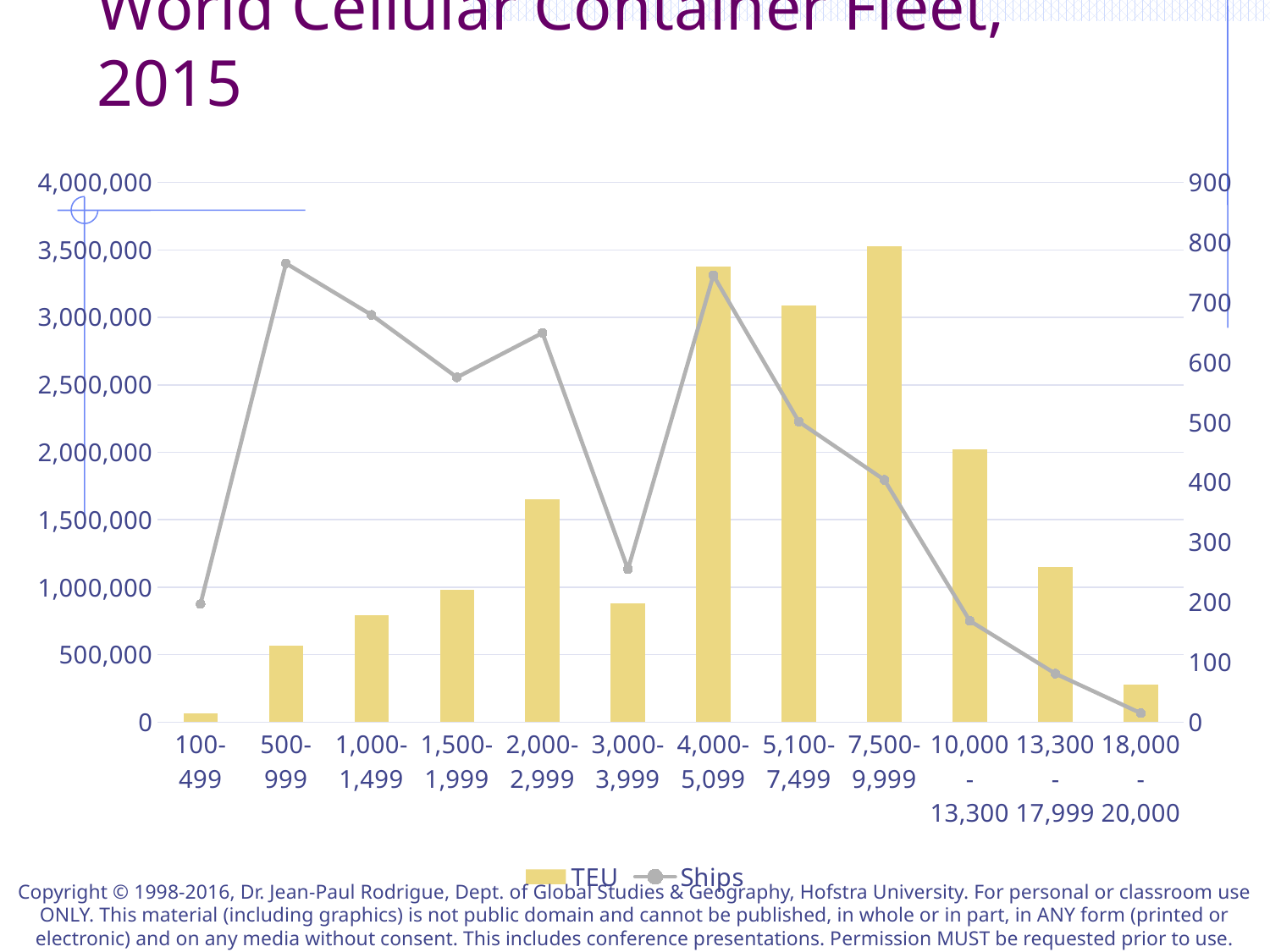
Which category has the shortest TEU bar? 100-499 What kind of chart is shown on the slide? A combination bar and line chart What are the two series named in the legend? TEU and Ships Which category has the lowest value on the Ships line? 18,000-20,000 Is the TEU value for 2,000-2,999 greater or less than 1,500,000? greater How many ship-size categories are shown on the x axis? 12 Which category has the tallest TEU bar? 7,500-9,999 Which has the larger TEU value, 500-999 or 1,000-1,499? 1,000-1,499 How many series does the legend list? 2 Is the Ships value for 10,000-13,300 greater or less than 200? less Does the Ships line rise or fall from 4,000-5,099 through 18,000-20,000? It falls Is the Ships value for 1,500-1,999 greater or less than 500? greater